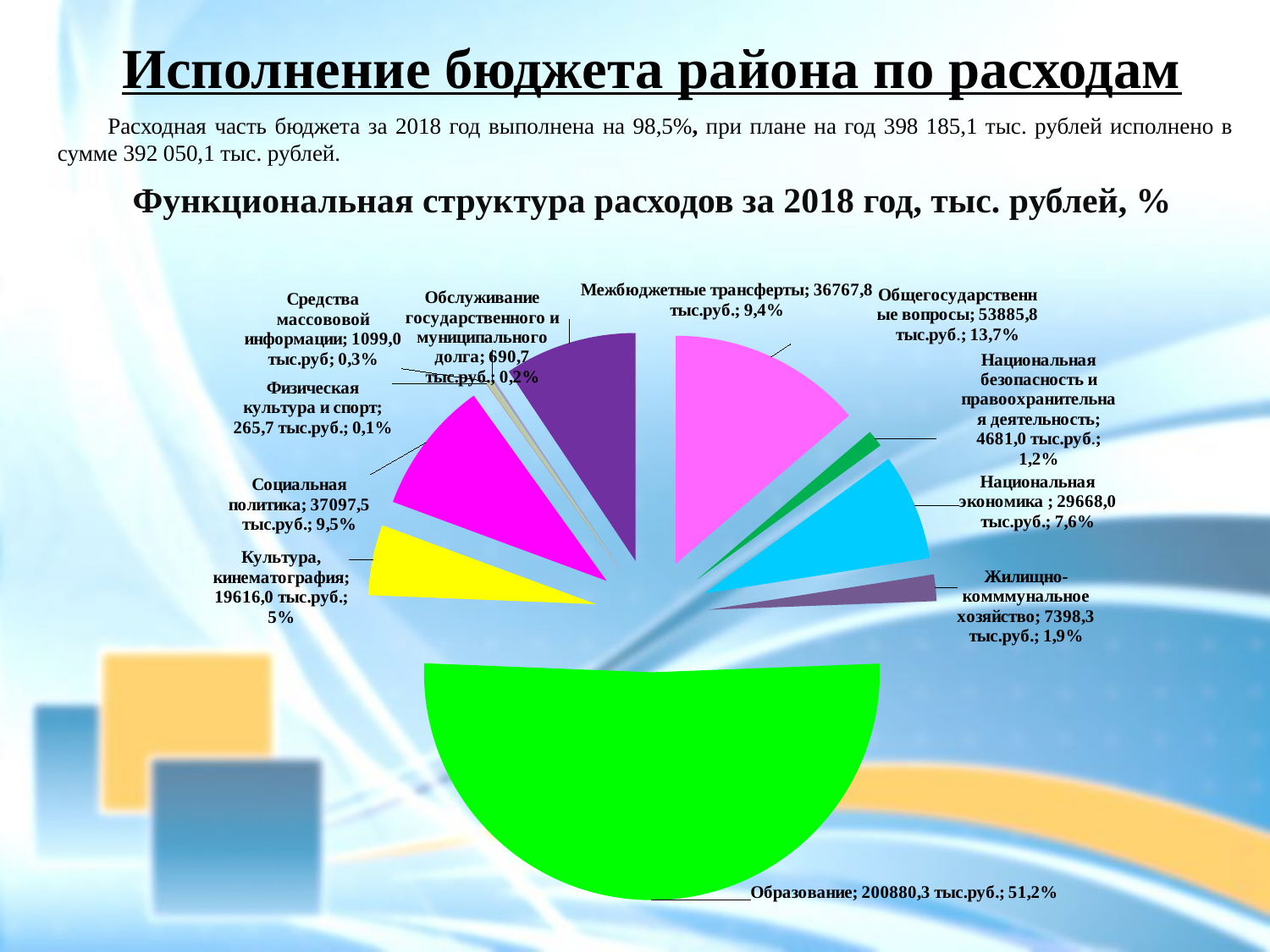
What is the value for Национальная экономика in тыс.руб.? 29668,0 тыс.руб. Which is larger: Социальная политика or Межбюджетные трансферты? Социальная политика What is the difference in percentage points between Общегосударственные вопросы (13,7%) and Национальная экономика (7,6%)? 6,1 Which category has the largest slice of the pie? Образование Which category has the smallest slice of the pie? Физическая культура и спорт What is the value for Образование in тыс.руб.? 200880,3 тыс.руб. What share of the pie does Общегосударственные вопросы represent? 13,7% What is the value for Культура, кинематография in тыс.руб.? 19616,0 тыс.руб. What is the title of the chart? Функциональная структура расходов за 2018 год, тыс. рублей, % What share of the pie does Жилищно-коммунальное хозяйство represent? 1,9% How many categories (slices) does the pie chart show? 11 What kind of chart is shown on the slide? Pie chart